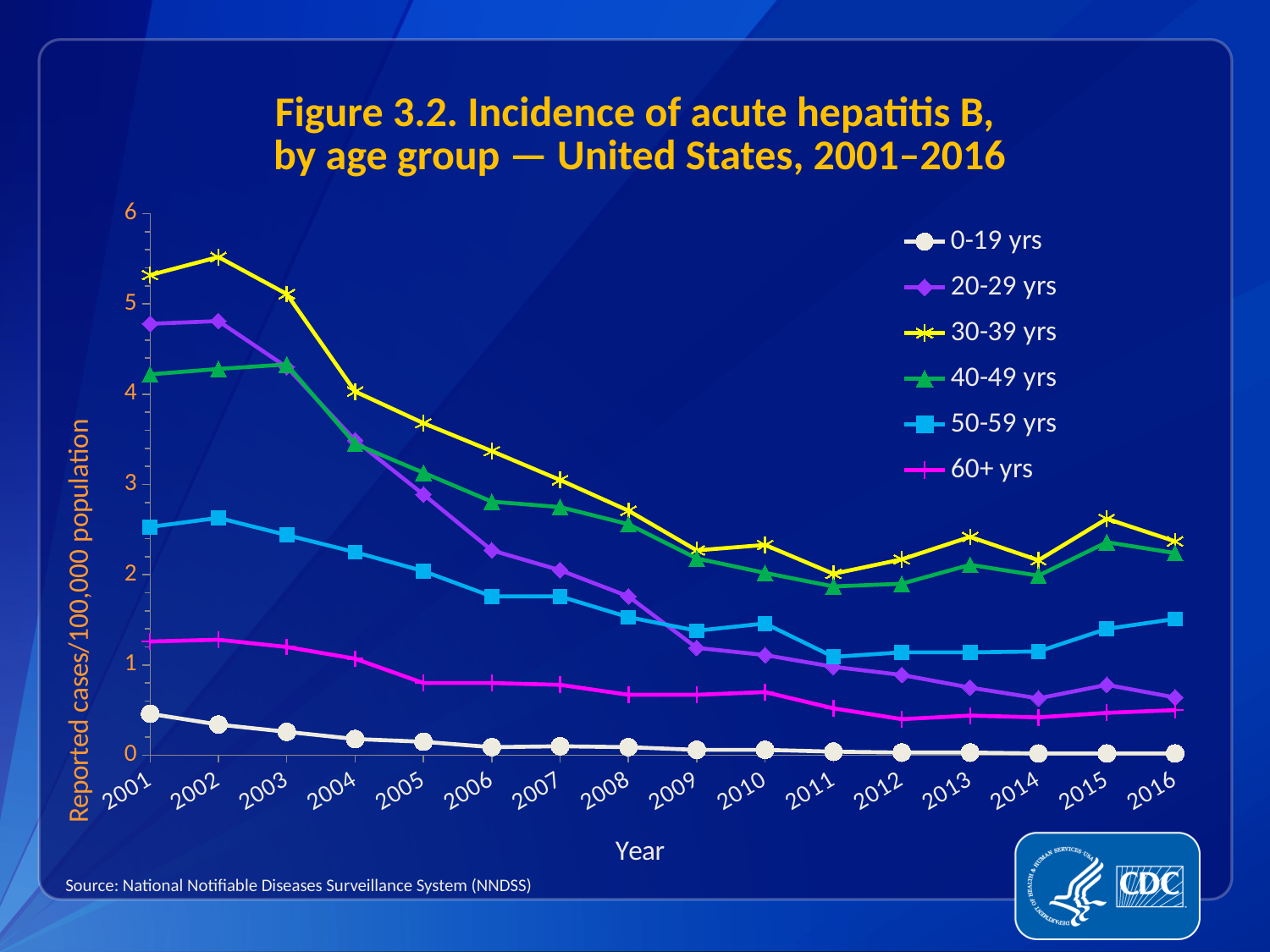
Is the value for the 20-29 yrs group in 2016 greater or less than 1? less How many age-group series does the legend list? 6 In 2001, which group had the higher incidence: 20-29 yrs or 40-49 yrs? 20-29 yrs In 2009, which group had the higher incidence: 40-49 yrs or 50-59 yrs? 40-49 yrs Which age group had the highest incidence of acute hepatitis B in 2001? 30-39 yrs What kind of chart is shown on the slide? line chart Which age group had the lowest incidence of acute hepatitis B in 2001? 0-19 yrs Is the value for the 50-59 yrs group in 2001 greater or less than 2? greater How many years are plotted along the x axis? 16 Does the incidence for the 0-19 yrs group rise or fall from 2001 to 2016? fall Is the value for the 30-39 yrs group in 2002 greater or less than 5? greater What is the label on the y axis of the chart? Reported cases/100,000 population